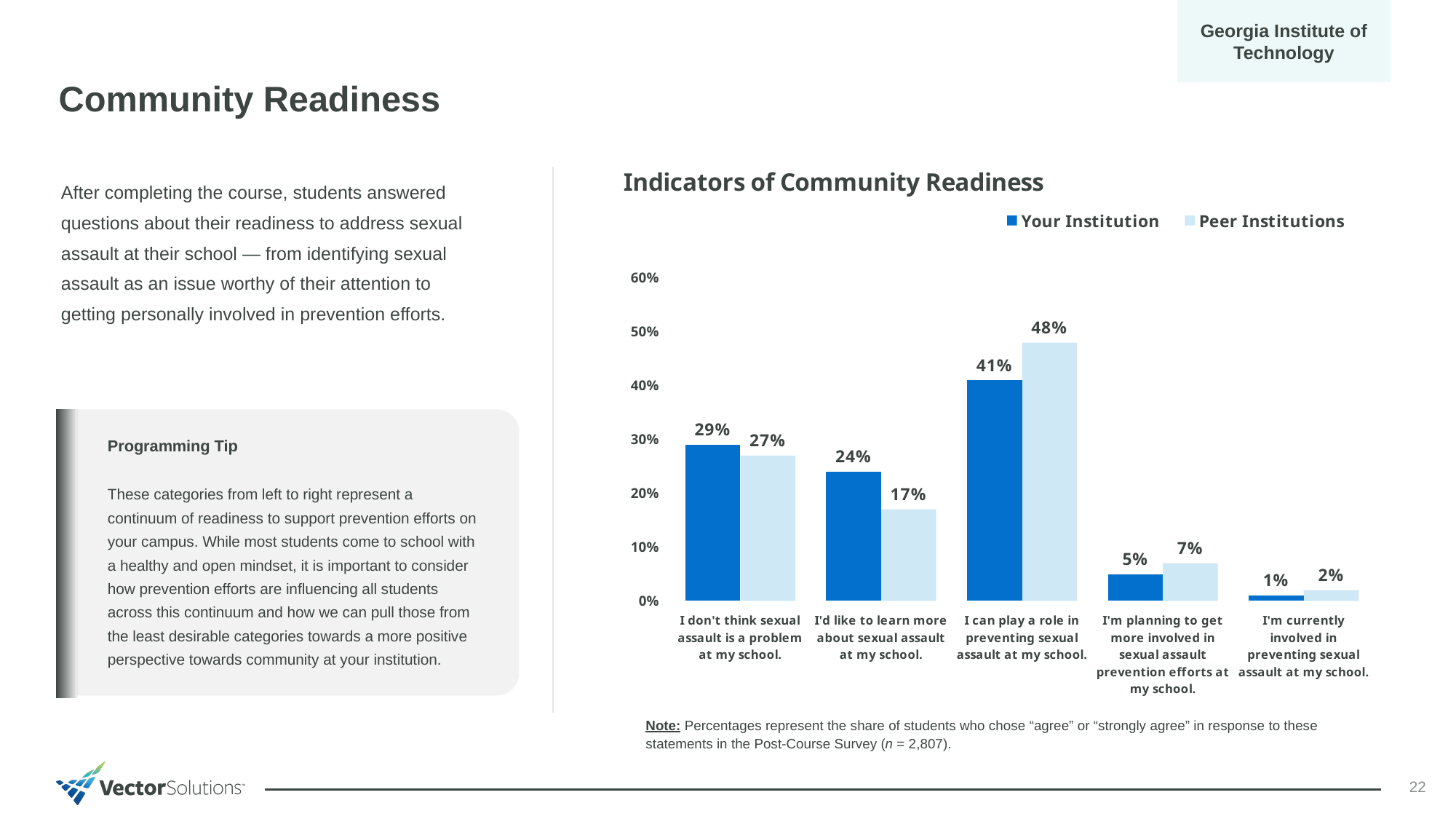
Which category has the lowest Your Institution value? I'm currently involved in preventing sexual assault at my school. Which category has the highest Peer Institutions value? I can play a role in preventing sexual assault at my school. What is the difference between the Peer Institutions and Your Institution values for "I can play a role in preventing sexual assault at my school."? 7% How many categories are shown on the x axis of the chart? 5 For "I don't think sexual assault is a problem at my school.", which is larger: Your Institution or Peer Institutions? Your Institution How many series does the legend list? 2 Is the Your Institution value for "I'm planning to get more involved in sexual assault prevention efforts at my school." greater or less than 10%? less What is the difference between the Your Institution and Peer Institutions values for "I'd like to learn more about sexual assault at my school."? 7% What is the Peer Institutions value for "I'd like to learn more about sexual assault at my school."? 17% What is the Your Institution value for "I can play a role in preventing sexual assault at my school."? 41% What kind of chart is shown on the slide? Bar chart What is the Your Institution value for "I'm currently involved in preventing sexual assault at my school."? 1%